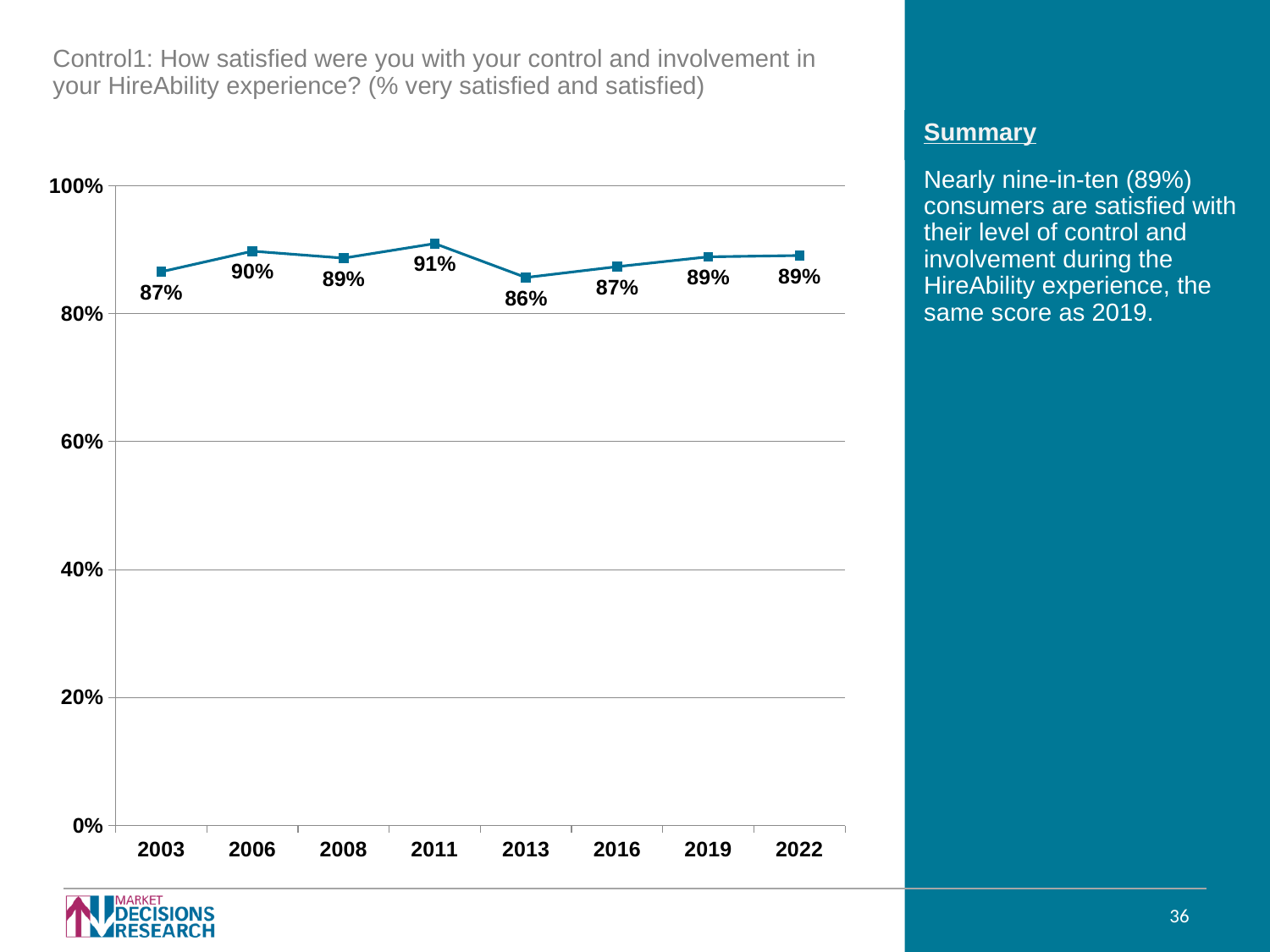
Which year had a higher satisfaction percentage, 2006 or 2016? 2006 Did the satisfaction percentage rise or fall from 2013 to 2022? Rise Which year had the lowest satisfaction percentage? 2013 What was the percentage of satisfied consumers in 2013? 86% What is the difference in percentage points between 2011 and 2013? 5 What is the first year shown on the x axis? 2003 What was the percentage of satisfied consumers in 2011? 91% What was the percentage of satisfied consumers in 2022? 89% What kind of chart is shown on the slide? Line chart Which year had the highest satisfaction percentage? 2011 Is the value for 2003 greater or less than 80%? greater How many years are plotted on the chart? 8